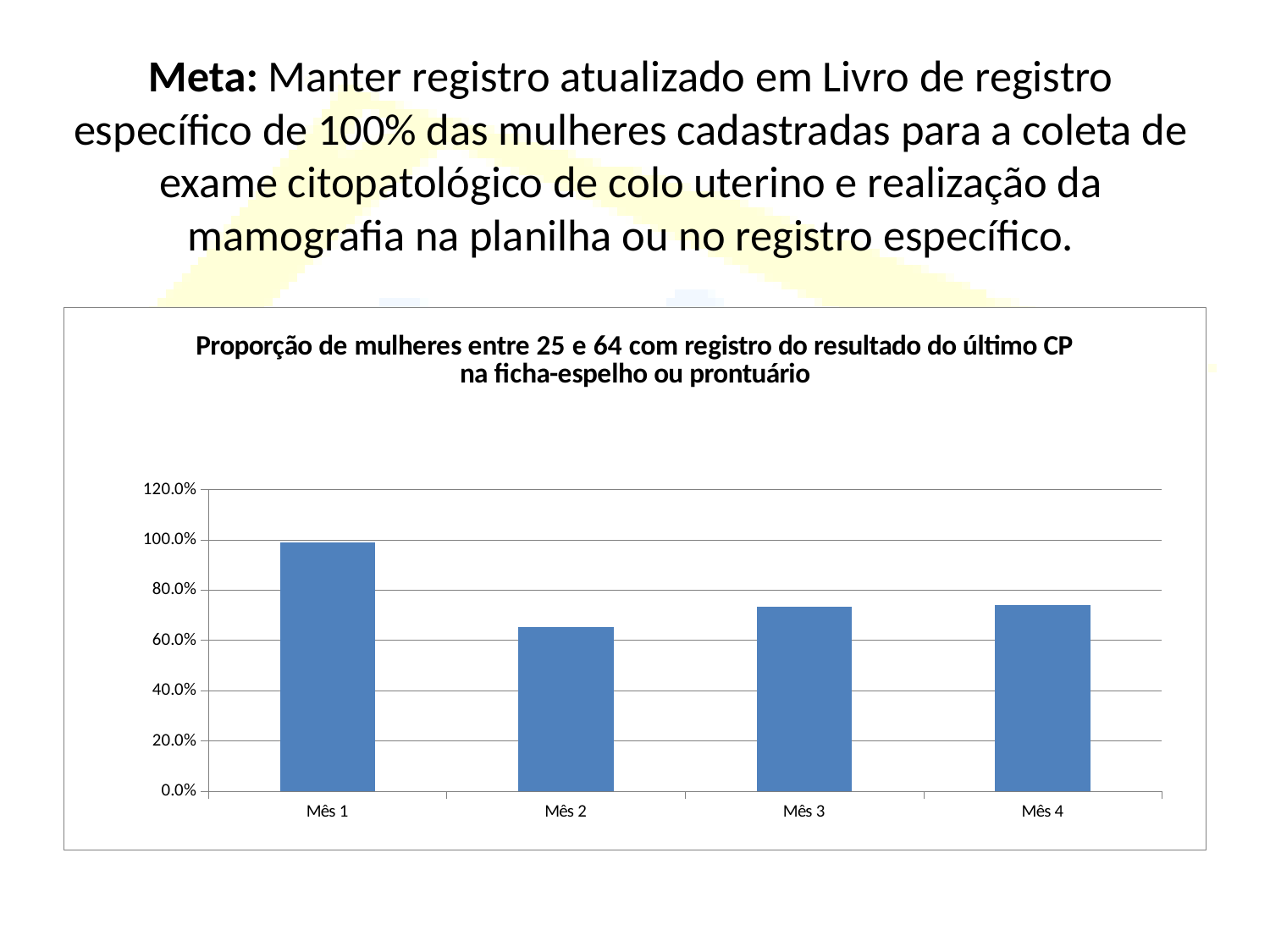
Is the value for Mês 3 greater or less than 60.0%? greater Is the value for Mês 2 greater or less than 80.0%? less Which month has the lowest proportion in the chart? Mês 2 Is the value for Mês 1 greater or less than 80.0%? greater What is the highest tick value shown on the chart's vertical axis? 120.0% Does the value rise or fall from Mês 1 to Mês 2? fall Which month has the highest proportion in the chart? Mês 1 Which is larger, the value for Mês 1 or the value for Mês 3? Mês 1 How many months (categories) are plotted on the x axis of the chart? 4 What kind of chart is shown on the slide? bar chart Does the value rise or fall from Mês 2 to Mês 3? rise